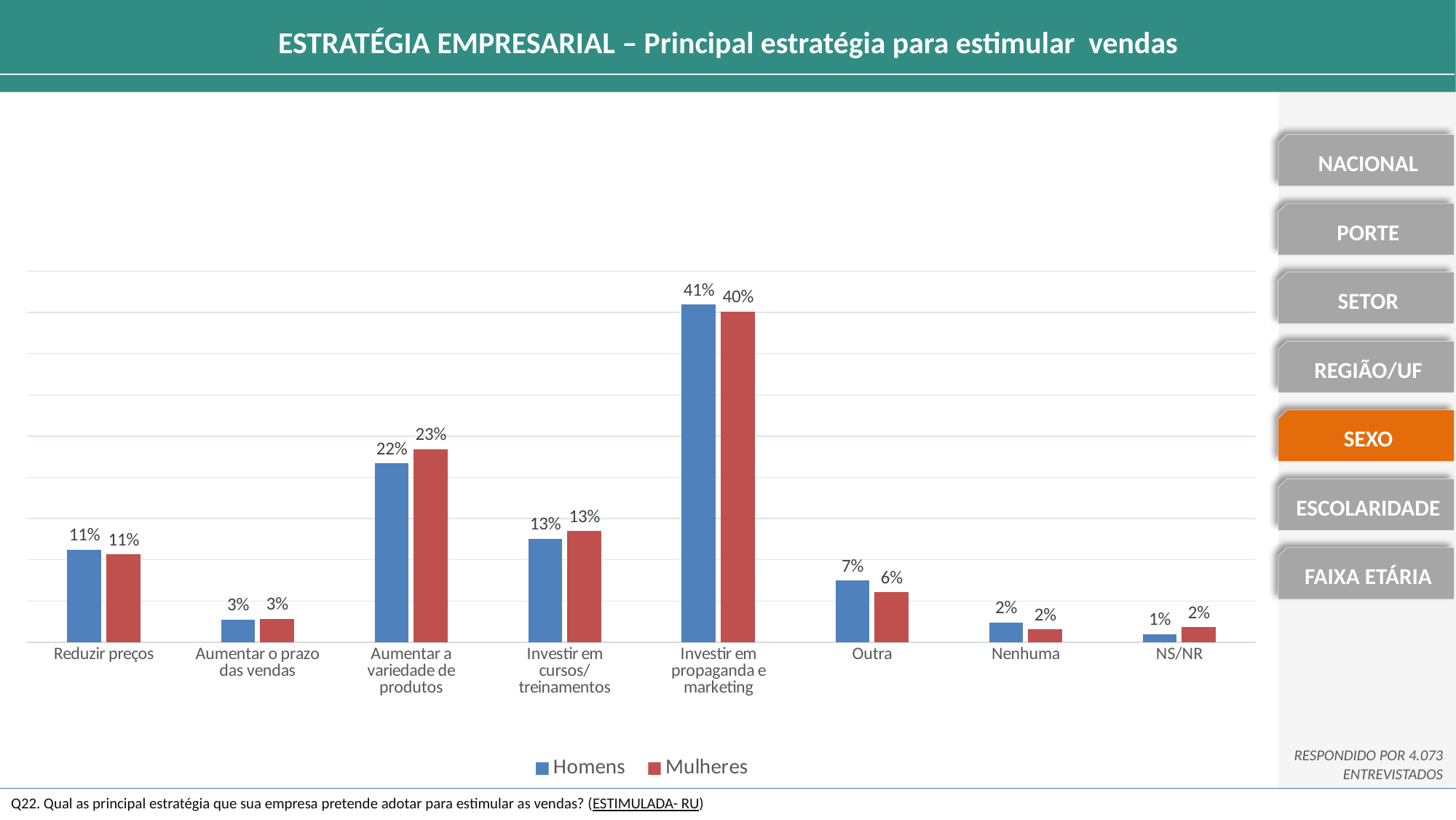
What is the value for Homens in the 'Reduzir preços' category? 11% Which category has the highest value for Homens? Investir em propaganda e marketing What is the value for Mulheres in the 'Aumentar a variedade de produtos' category? 23% What kind of chart is shown on the slide? Bar chart What is the difference between the Homens and Mulheres values for 'Investir em propaganda e marketing'? 1 percentage point Which is larger for 'Outra': the Homens value or the Mulheres value? Homens How many series does the legend list? 2 What is the value for Mulheres in the 'Outra' category? 6% Which category has the lowest value for Homens? NS/NR What are the two series named in the legend? Homens and Mulheres What is the value for Homens in the 'Investir em propaganda e marketing' category? 41% How many categories are shown on the x axis? 8